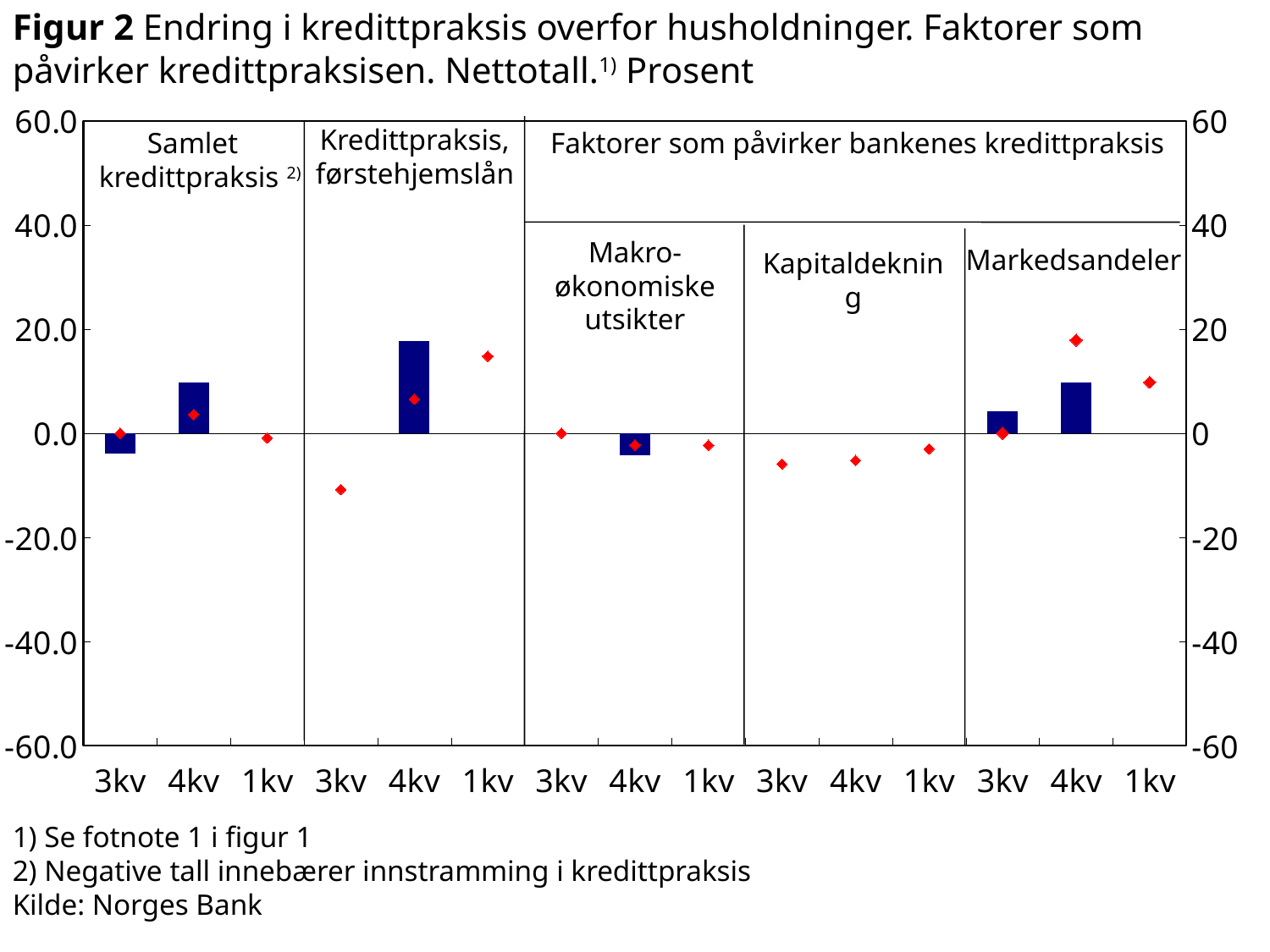
Is the 3kv marker in the Kredittpraksis, førstehjemslån panel greater or less than 0? less What kind of chart is shown on the slide? combination bar and line chart (bars with diamond markers) How many quarter labels (categories) are shown along the x axis? 15 Is the 4kv bar in the Makroøkonomiske utsikter panel greater or less than 0? less Is the 4kv bar in the Kredittpraksis, førstehjemslån panel greater or less than 20? less What is the source given below the chart? Norges Bank In which panel does the tallest bar appear? Kredittpraksis, førstehjemslån Which is larger: the 4kv bar in the Markedsandeler panel or the 4kv bar in the Kredittpraksis, førstehjemslån panel? Kredittpraksis, førstehjemslån How many panels (sections) is the chart divided into along the x axis? 5 How many bars are plotted in the chart in total? 6